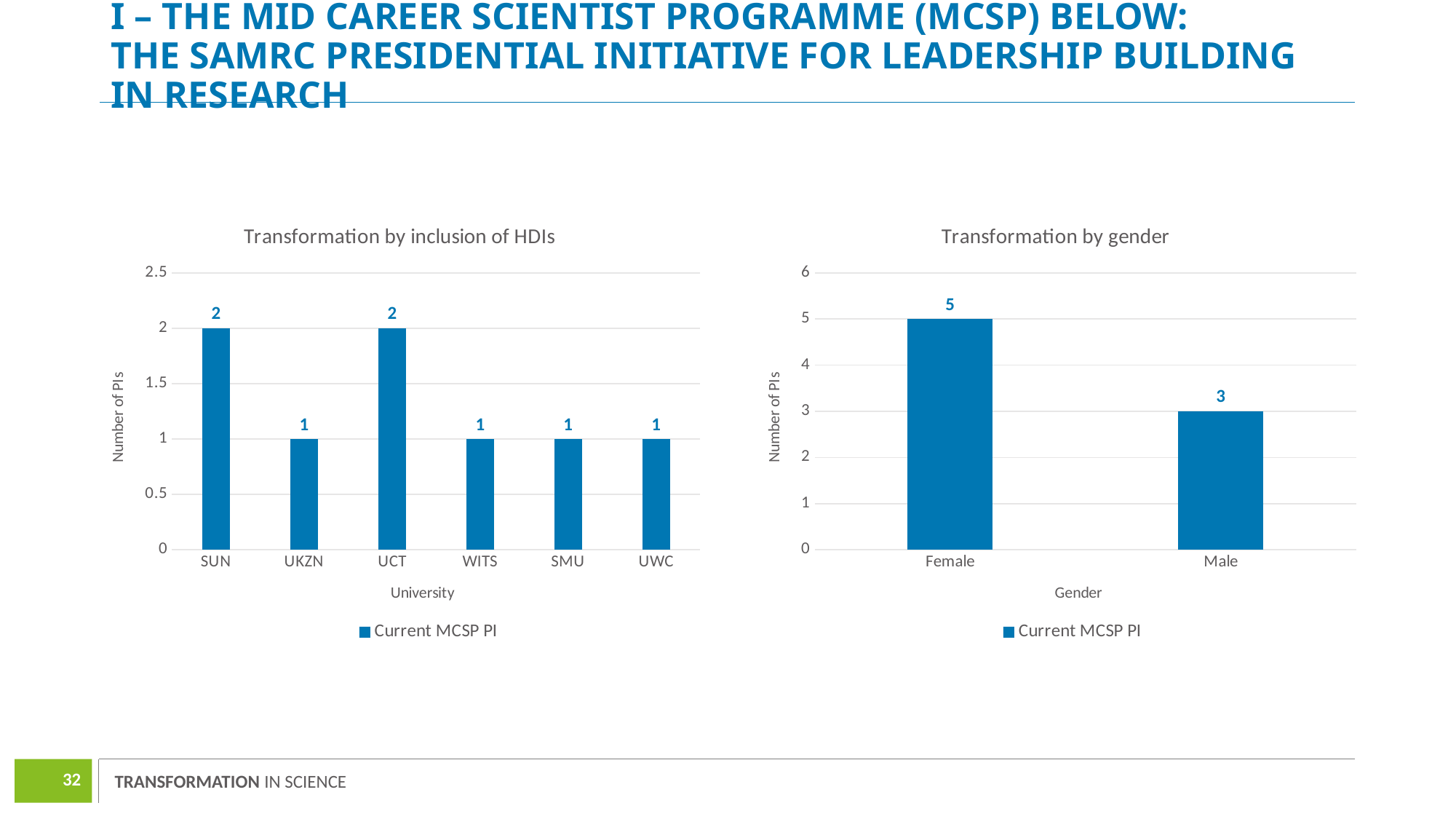
What is the legend entry in the 'Transformation by inclusion of HDIs' chart? Current MCSP PI In the 'Transformation by inclusion of HDIs' chart, which is larger, the value for SUN or the value for SMU? SUN In the 'Transformation by inclusion of HDIs' chart, what is the value for WITS? 1 In the 'Transformation by inclusion of HDIs' chart, what is the value for SUN? 2 In the 'Transformation by inclusion of HDIs' chart, what is the difference between the values for UCT and UKZN? 1 How many series does the legend of the 'Transformation by gender' chart list? 1 What kind of chart is the 'Transformation by inclusion of HDIs' chart? Bar chart In the 'Transformation by gender' chart, what is the difference between the Female and Male values? 2 How many universities are shown in the 'Transformation by inclusion of HDIs' chart? 6 In the 'Transformation by gender' chart, what is the value for Male? 3 In the 'Transformation by gender' chart, which category has the highest value? Female In the 'Transformation by gender' chart, what is the value for Female? 5